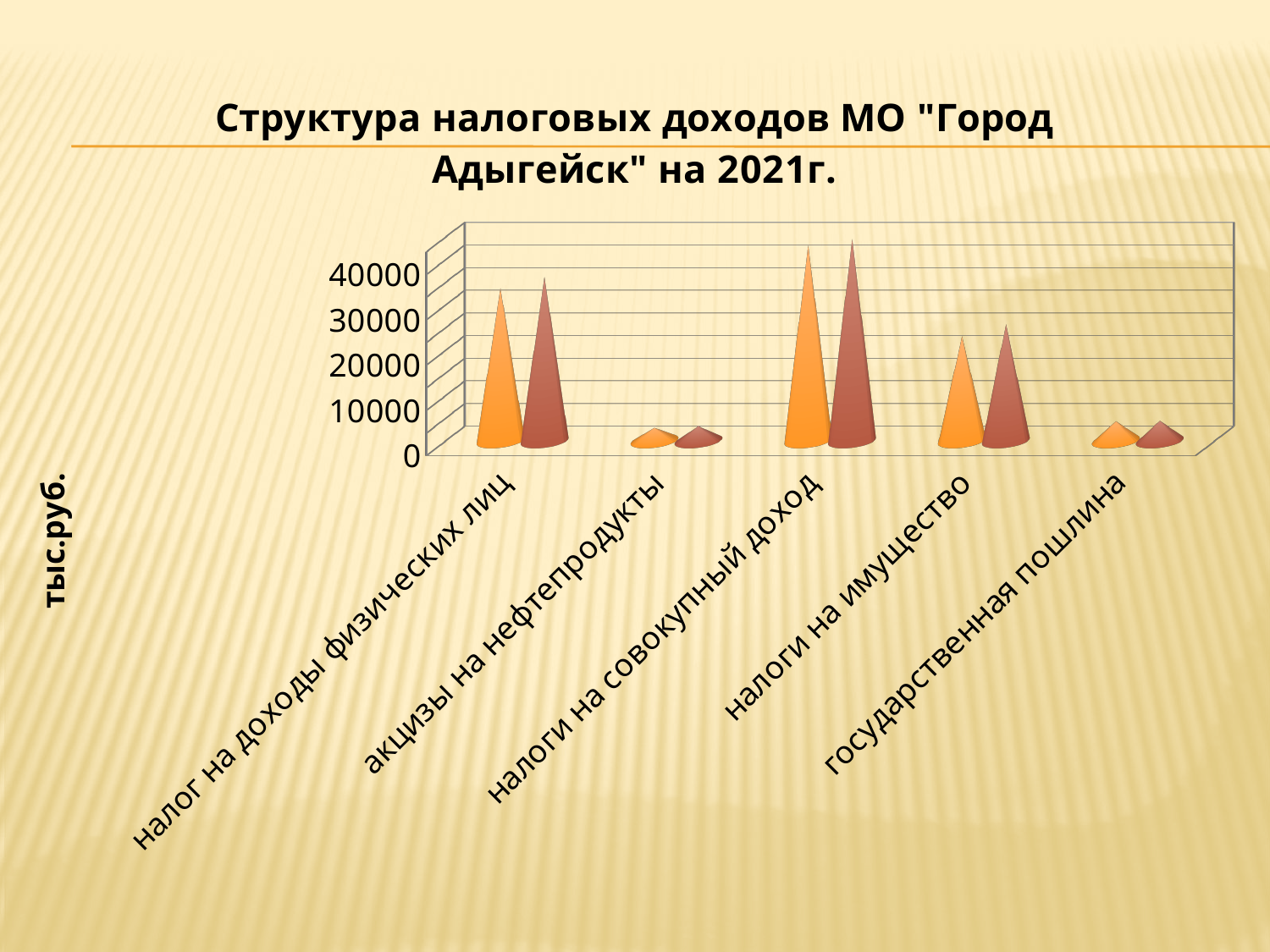
What kind of chart is shown on the slide? bar chart Is the value of the orange bar for налоги на имущество greater or less than 30000? less Is the value of the brown bar for налоги на совокупный доход greater or less than 40000? greater Is the value of the orange bar for государственная пошлина greater or less than 10000? less How many tax categories are shown on the x axis of the chart? 5 What unit is given on the vertical axis label of the chart? тыс.руб. Which is larger in the brown series: налоги на совокупный доход or налог на доходы физических лиц? налоги на совокупный доход Which is larger in the orange series: налог на доходы физических лиц or налоги на имущество? налог на доходы физических лиц Which category has the highest values in the chart? налоги на совокупный доход